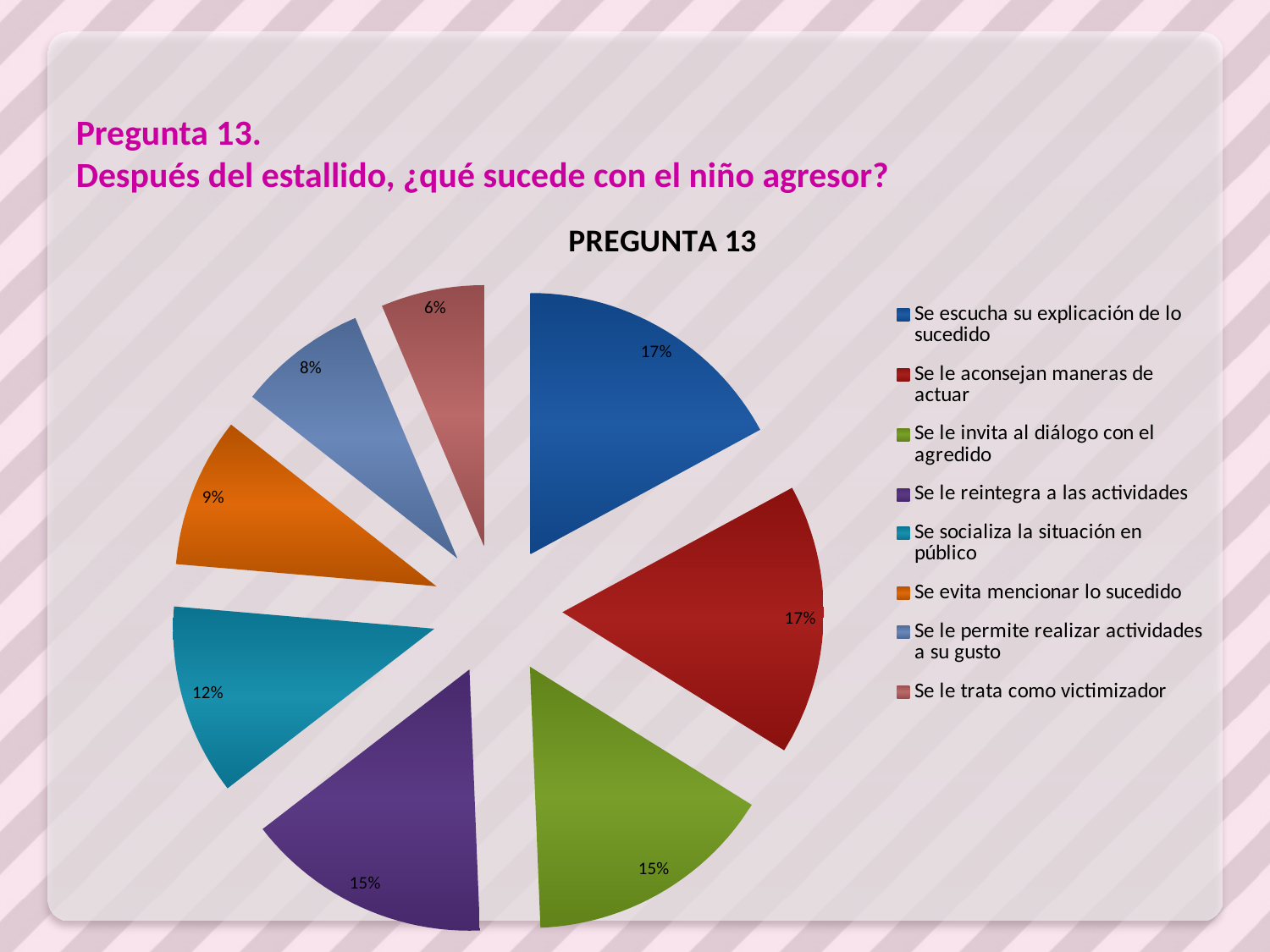
What colour is the slice for 'Se evita mencionar lo sucedido'? Orange Which category has the smallest slice of the pie? Se le trata como victimizador What share of the pie is 'Se evita mencionar lo sucedido'? 9% What share of the pie is 'Se le permite realizar actividades a su gusto'? 8% What share of the pie is 'Se socializa la situación en público'? 12% What is the title of the chart? PREGUNTA 13 What is the difference between the shares of 'Se le aconsejan maneras de actuar' and 'Se evita mencionar lo sucedido'? 8% How many slices does the pie chart have? 8 What kind of chart is shown on the slide? Pie chart Which is larger: 'Se le reintegra a las actividades' or 'Se le trata como victimizador'? Se le reintegra a las actividades